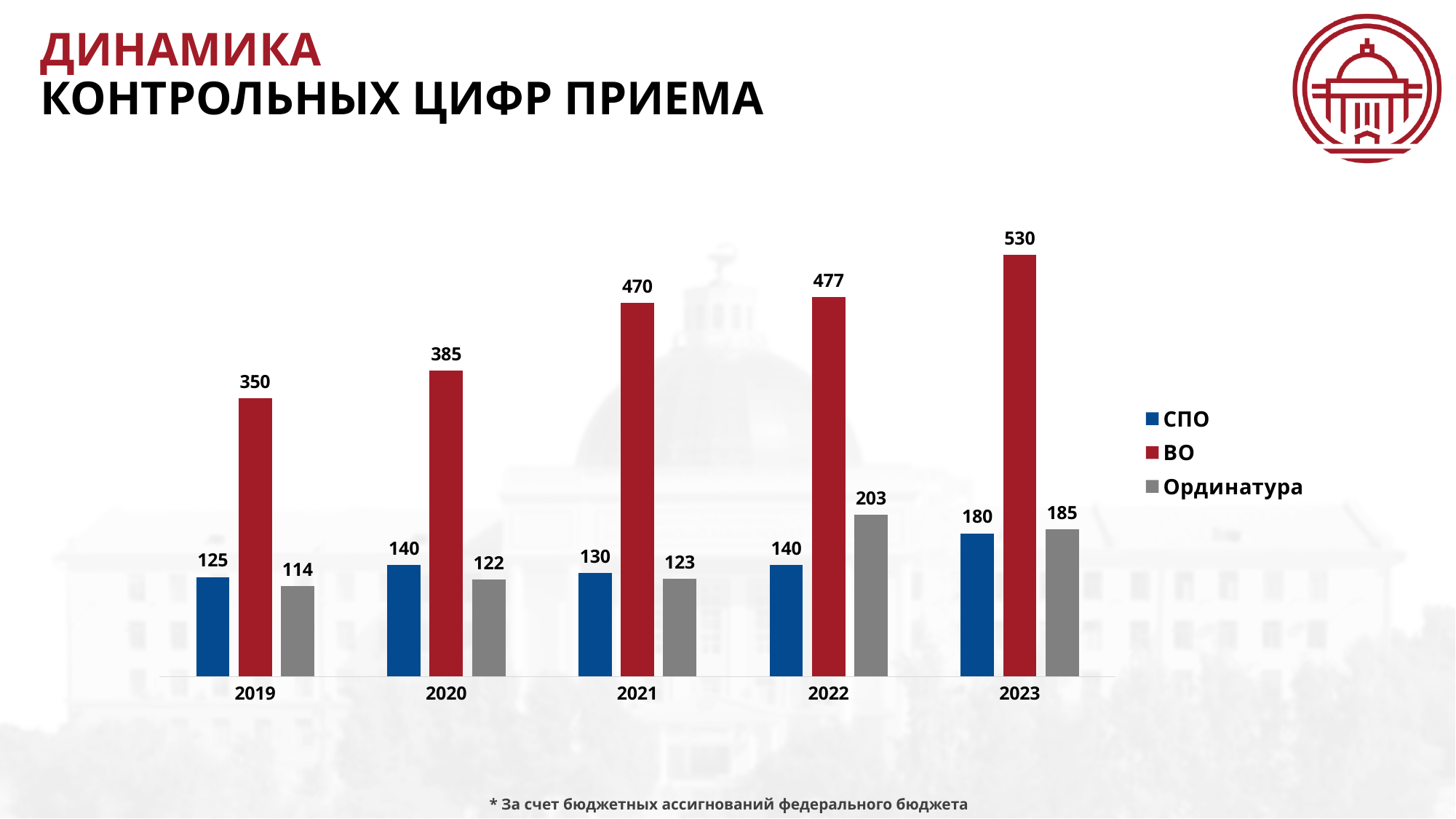
In which year is the ВО value highest? 2023 Do the ВО values rise or fall from 2019 to 2023? Rise What is the value for Ординатура in 2022? 203 In which year is the Ординатура value lowest? 2019 How many years are shown on the x axis? 5 What colour are the ВО bars? Red What kind of chart is shown on the slide? Bar chart How many series does the legend list? 3 What is the difference between the ВО values for 2023 and 2019? 180 What is the value for СПО in 2019? 125 Which is larger in 2023: СПО or Ординатура? Ординатура What is the value for ВО in 2023? 530